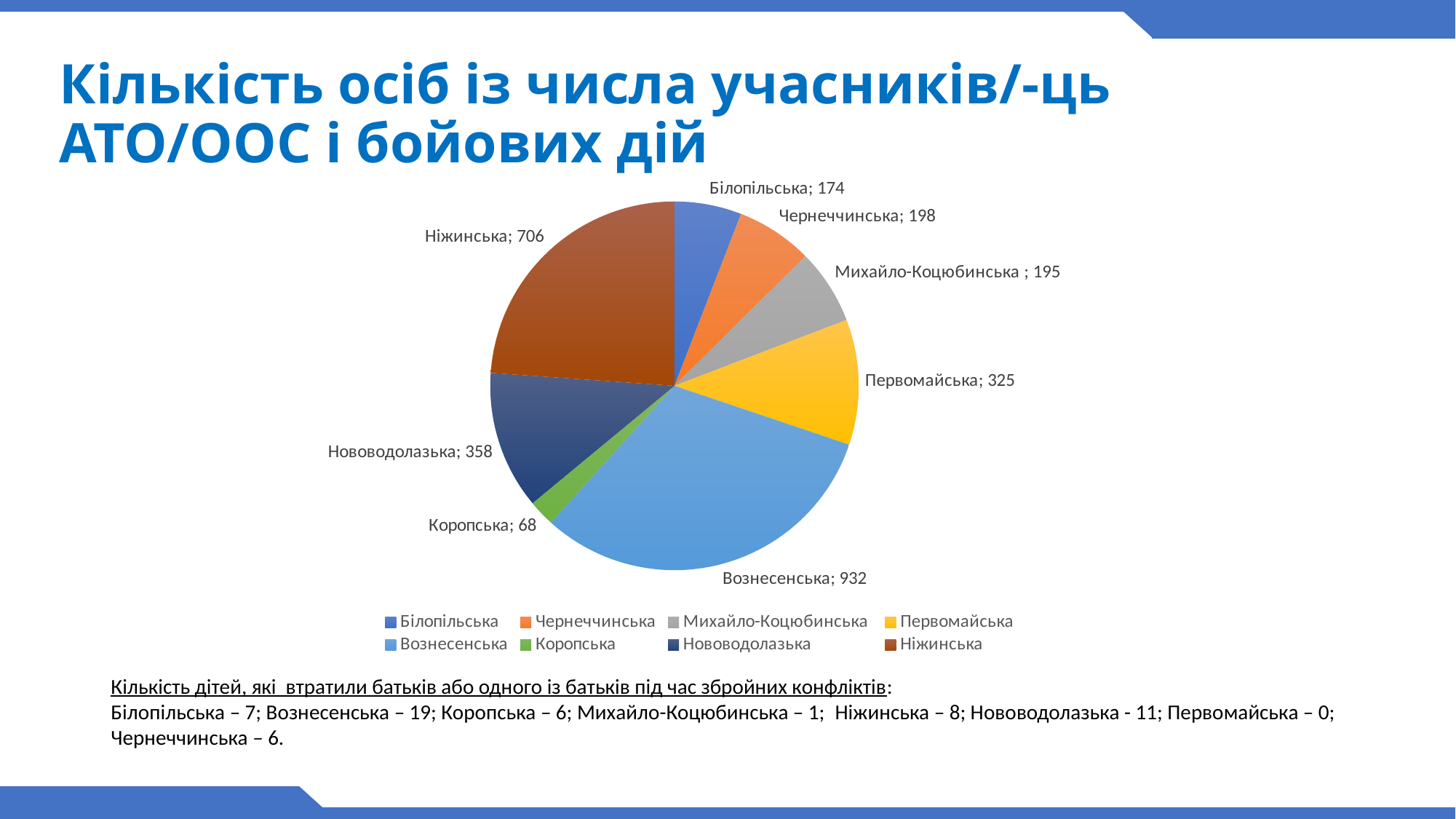
What value is shown for Вознесенська in the pie chart? 932 Which category has the smallest slice in the pie chart? Коропська What is the total of all values shown in the pie chart? 2956 Which is larger, the value for Нововодолазька or the value for Первомайська? Нововодолазька Which category has the largest slice in the pie chart? Вознесенська What value is shown for Нововодолазька in the pie chart? 358 What value is shown for Михайло-Коцюбинська in the pie chart? 195 What colour is the Ніжинська slice in the pie chart? Brown How many categories are shown in the pie chart? 8 What is the difference between the values for Вознесенська and Ніжинська? 226 What is the difference between the values for Первомайська and Білопільська? 151 What type of chart is shown on the slide? Pie chart